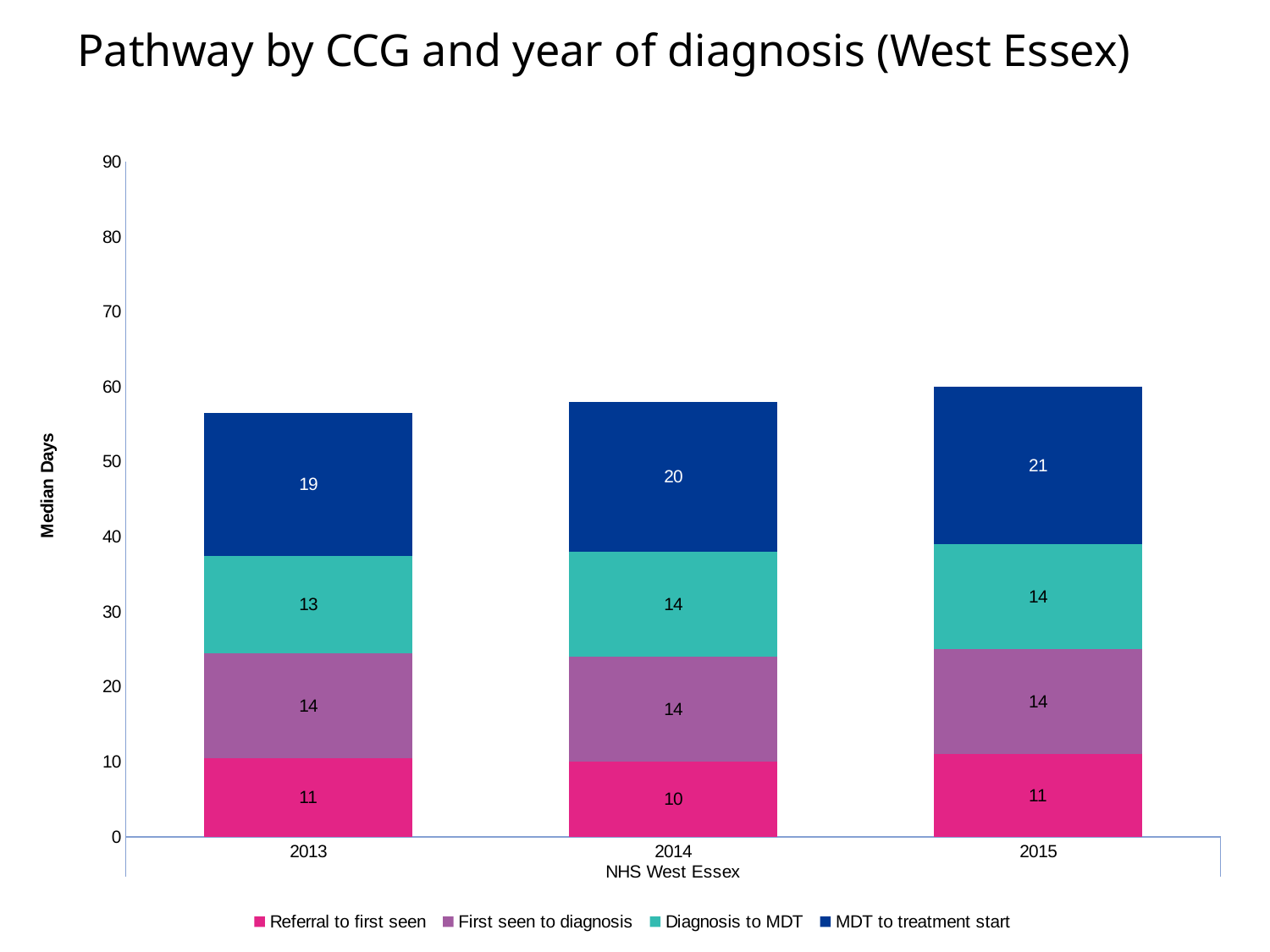
How many series does the legend list? 4 How many years are shown on the x axis? 3 Which is larger, the Diagnosis to MDT value for 2013 or for 2014? 2014 What is the difference between the MDT to treatment start values for 2015 and 2013? 2 What is the value for MDT to treatment start in 2015? 21 Which year has the highest value for MDT to treatment start? 2015 What is the total of the stacked bar for 2015? 60 Does the MDT to treatment start value rise or fall from 2013 to 2015? Rise What kind of chart is shown on the slide? Stacked bar chart What is the value for Referral to first seen in 2014? 10 Which year has the lowest value for Referral to first seen? 2014 What is the value for Diagnosis to MDT in 2013? 13